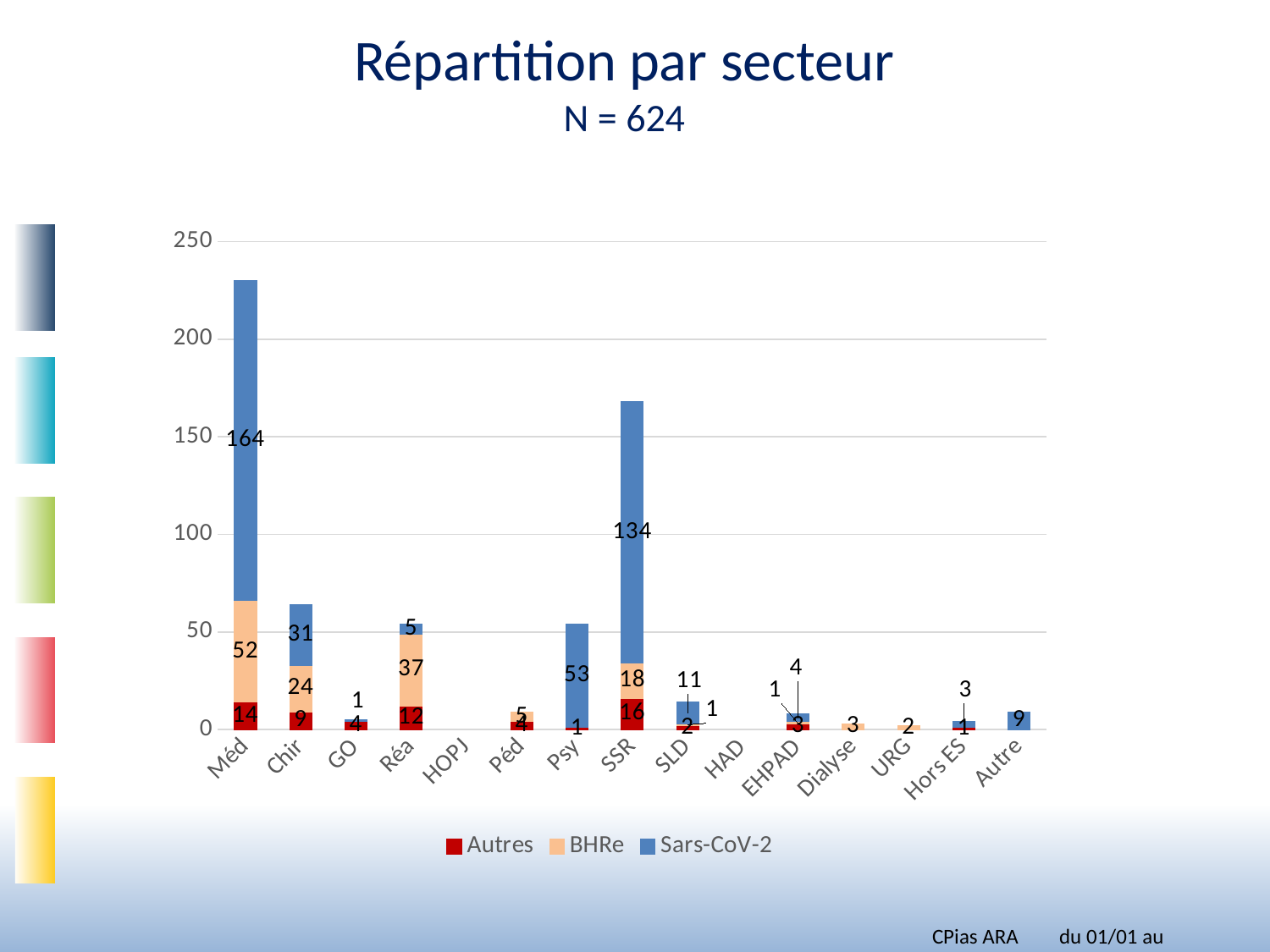
How many sector categories are shown on the x axis? 15 Which sector has the highest Sars-CoV-2 value? Méd What is the total of the stacked bar for Méd? 230 How many series does the legend list? 3 What kind of chart is shown on the slide? Stacked bar chart What is the difference between the Sars-CoV-2 values for Méd and SSR? 30 Which is larger, the BHRe value for Méd or the BHRe value for Réa? Méd Is the total of the stacked bar for Chir greater or less than 50? greater What is the title of the chart? Répartition par secteur What is the Sars-CoV-2 value for Méd? 164 What is the Sars-CoV-2 value for SSR? 134 What is the BHRe value for Réa? 37